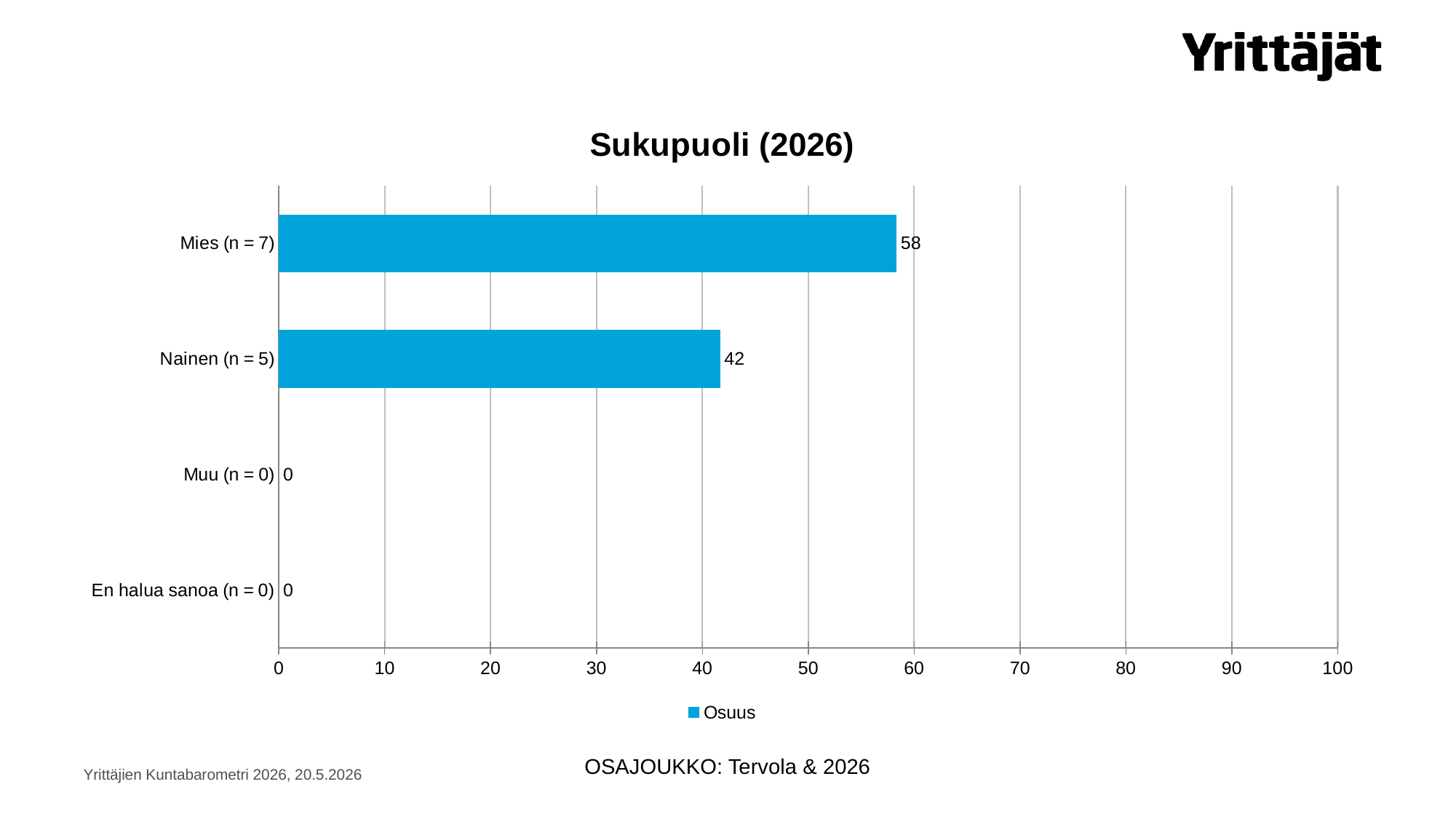
What is the title of the chart? Sukupuoli (2026) What is the value for Nainen (n = 5)? 42 What kind of chart is shown on the slide? bar chart Is the value for Nainen (n = 5) greater or less than 50? less How many series does the legend list? 1 How many categories are shown on the chart? 4 What is the value for En halua sanoa (n = 0)? 0 What is the difference between the values for Mies (n = 7) and Nainen (n = 5)? 16 What is the value for Muu (n = 0)? 0 Which category has the highest value? Mies (n = 7) Which is larger, the value for Mies (n = 7) or the value for Nainen (n = 5)? Mies (n = 7) What is the value for Mies (n = 7)? 58